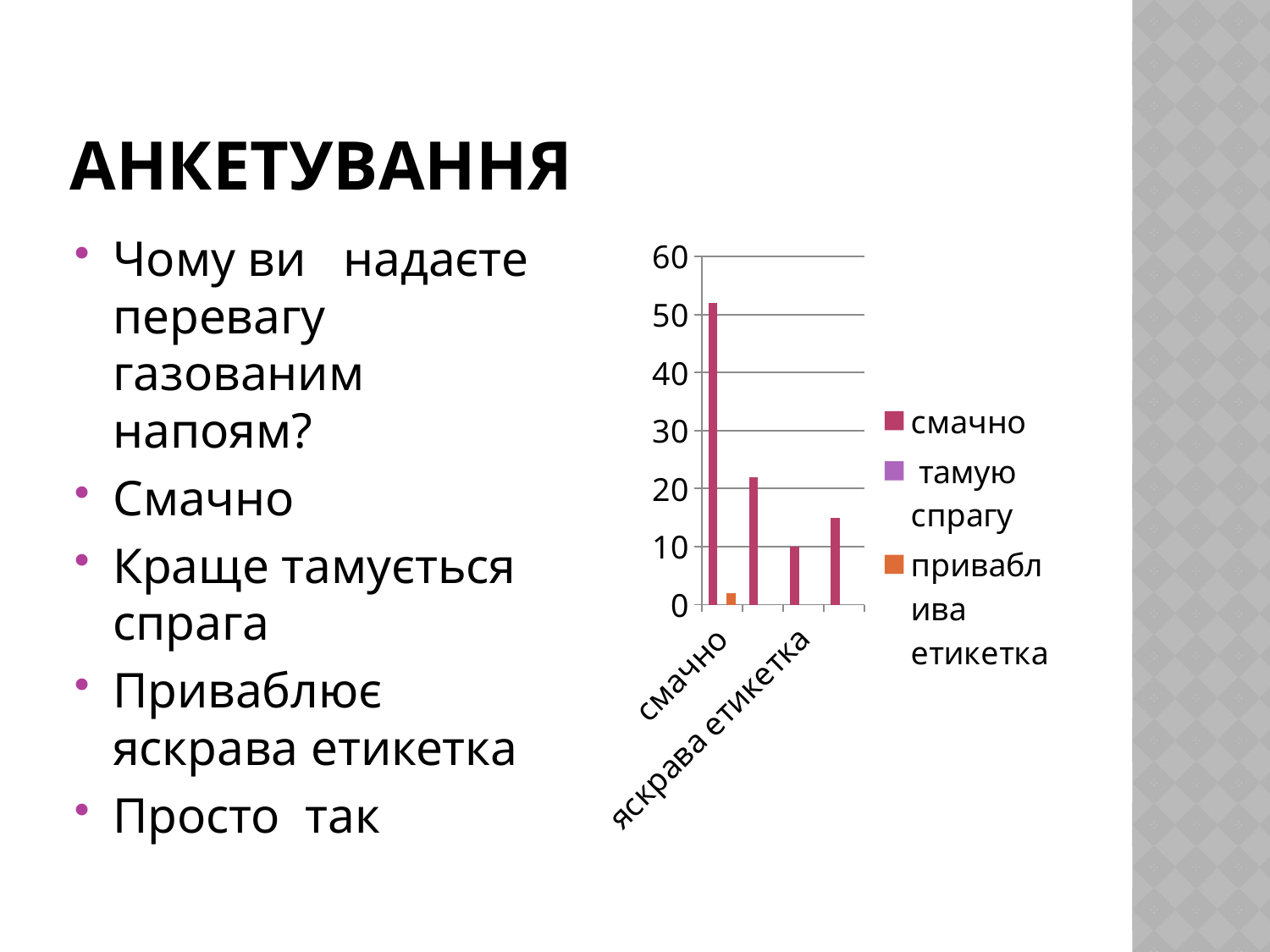
What are the three entries listed in the chart legend? смачно, тамую спрагу, приваблива етикетка Which category has the highest bar in the chart? смачно Is the value for яскрава етикетка greater or less than 30? less How many category positions are plotted along the x axis of the chart? 4 Is the value for смачно greater or less than 40? greater Which is larger, the value for смачно or the value for яскрава етикетка? смачно What is the highest value shown on the chart's vertical axis? 60 What kind of chart is shown on the slide? bar chart How many series does the chart legend list? 3 Is the value for смачно greater or less than 50? greater